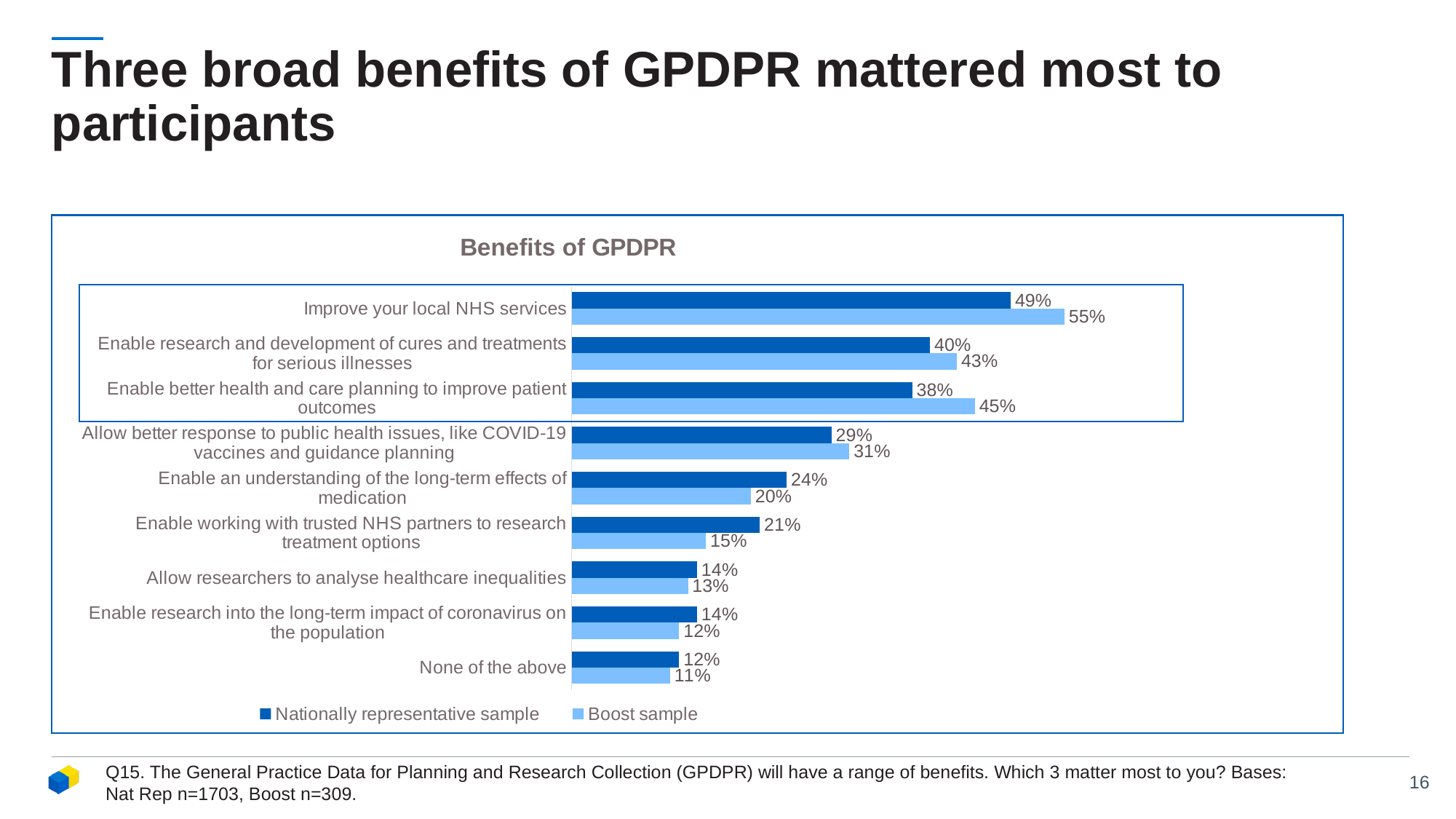
For 'Enable working with trusted NHS partners to research treatment options', which sample has the larger value? Nationally representative sample What is the difference between the Nationally representative sample and Boost sample values for 'Enable an understanding of the long-term effects of medication'? 4% What is the difference between the Boost sample and Nationally representative sample values for 'Enable better health and care planning to improve patient outcomes'? 7% What is the value for 'None of the above' in the Boost sample? 11% Which category has the highest value in the Nationally representative sample? Improve your local NHS services What is the value for 'Enable better health and care planning to improve patient outcomes' in the Nationally representative sample? 38% How many categories are shown in the chart? 9 Which category has the lowest value in the Boost sample? None of the above What is the title of the chart? Benefits of GPDPR What is the value for 'Improve your local NHS services' in the Boost sample? 55% How many series does the legend list? 2 What kind of chart is shown on the slide? Bar chart